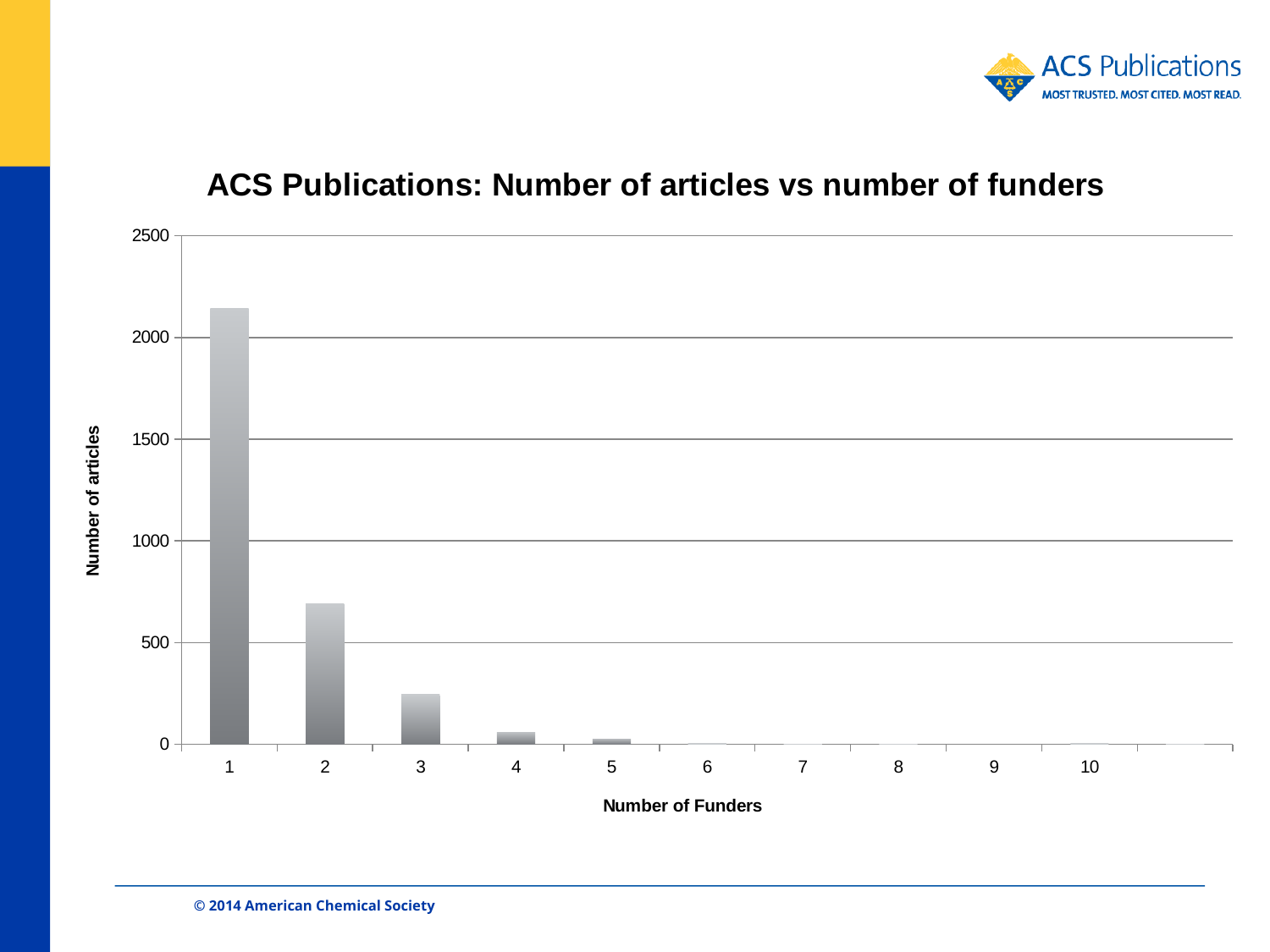
Which has more articles: 4 funders or 1 funder? 1 funder Is the number of articles for 3 funders greater or less than 500? less Which has more articles: 2 funders or 3 funders? 2 funders How many number-of-funders categories are labelled on the x axis? 10 Is the number of articles for 1 funder greater or less than 2000? greater What is the label of the y axis? Number of articles What kind of chart is shown on the slide? bar chart Is the number of articles for 2 funders greater or less than 1000? less What is the title of the chart? ACS Publications: Number of articles vs number of funders Do the number of articles rise or fall as the number of funders increases? fall Which number of funders has the highest number of articles? 1